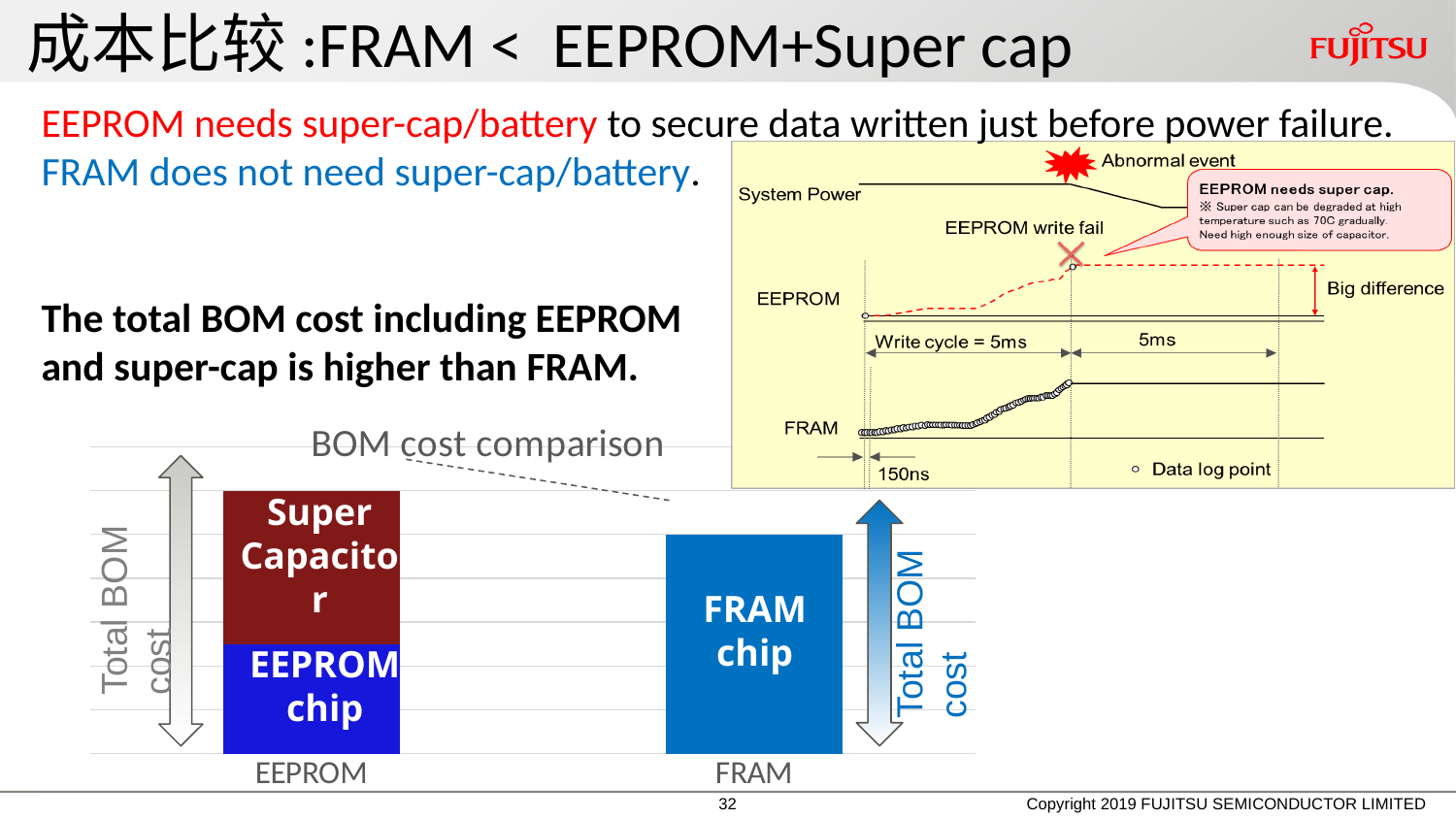
In the BOM cost comparison chart, which category has the taller total bar, EEPROM or FRAM? EEPROM In the BOM cost comparison chart, which segment sits on top of the EEPROM chip segment in the EEPROM bar? Super Capacitor What are the two segments that make up the EEPROM bar in the BOM cost comparison chart? EEPROM chip and Super Capacitor What does the vertical axis of the BOM cost comparison chart represent? Total BOM cost In the BOM cost comparison chart, which category has the lowest total BOM cost? FRAM How many categories are shown on the x axis of the BOM cost comparison chart? 2 In the BOM cost comparison chart, which category has the highest total BOM cost? EEPROM What is the title of the bar chart at the bottom of the slide? BOM cost comparison How many segments does the FRAM bar have in the BOM cost comparison chart? 1 In the BOM cost comparison chart, what is the label on the FRAM bar? FRAM chip What kind of chart is the BOM cost comparison chart? bar chart